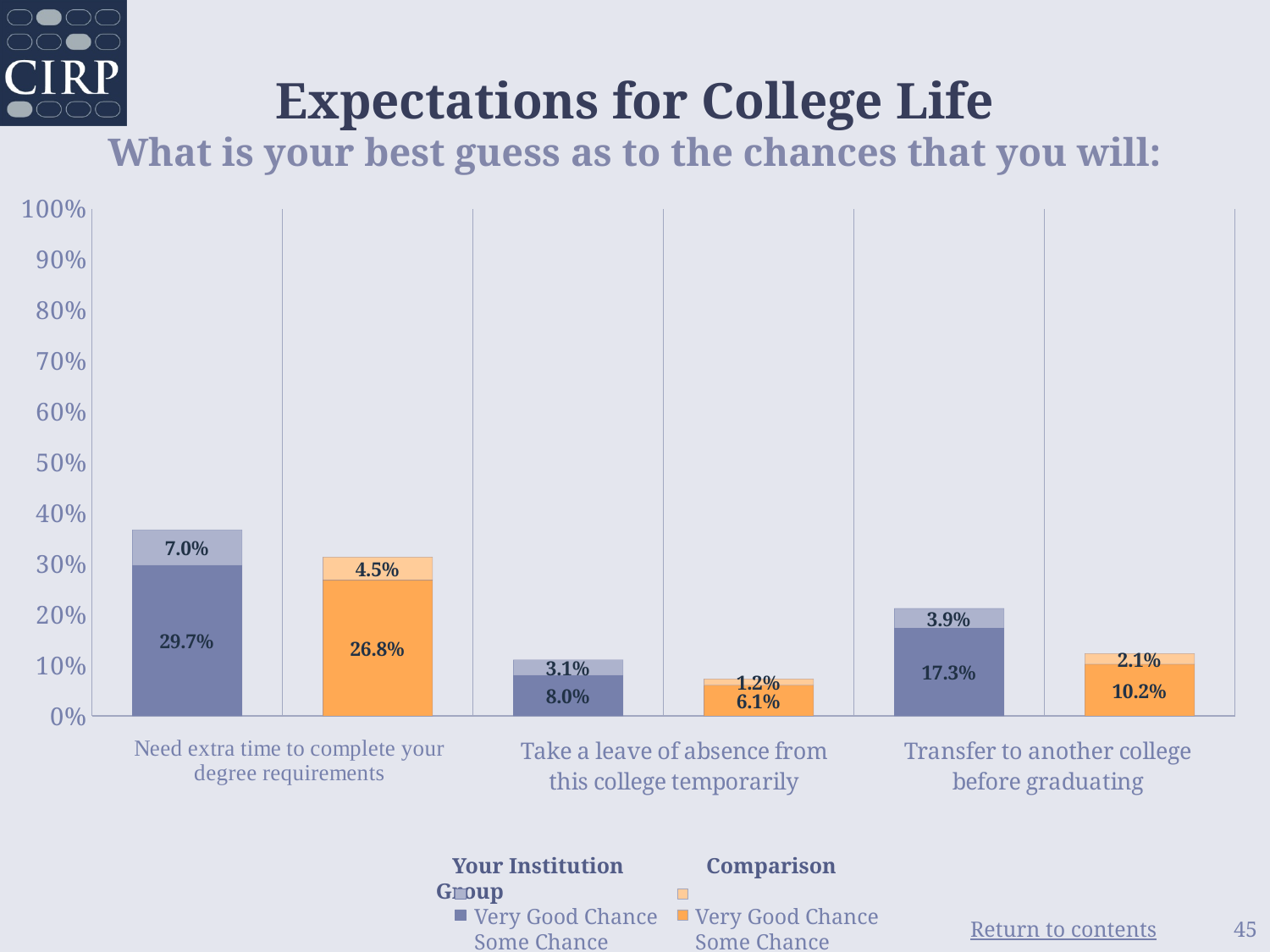
What is the total of the stacked bar for Your Institution for 'Need extra time to complete your degree requirements'? 36.7% Which category has the highest 'Very Good Chance' value for Your Institution? Need extra time to complete your degree requirements What kind of chart is shown on the slide? Stacked bar chart What is the total of the stacked bar for the Comparison Group for 'Take a leave of absence from this college temporarily'? 7.3% What is the difference between the 'Very Good Chance' values for Your Institution and the Comparison Group for 'Transfer to another college before graduating'? 1.8% Which is larger: the 'Very Good Chance' value for Your Institution or for the Comparison Group for 'Need extra time to complete your degree requirements'? Your Institution Which category has the lowest 'Very Good Chance' value for the Comparison Group? Take a leave of absence from this college temporarily What is the 'Very Good Chance' value for Your Institution for 'Need extra time to complete your degree requirements'? 7.0% What is the 'Some Chance' value for the Comparison Group for 'Transfer to another college before graduating'? 10.2% What is the 'Some Chance' value for Your Institution for 'Take a leave of absence from this college temporarily'? 8.0% How many categories are shown on the x axis of the chart? 3 What is the 'Very Good Chance' value for the Comparison Group for 'Take a leave of absence from this college temporarily'? 1.2%